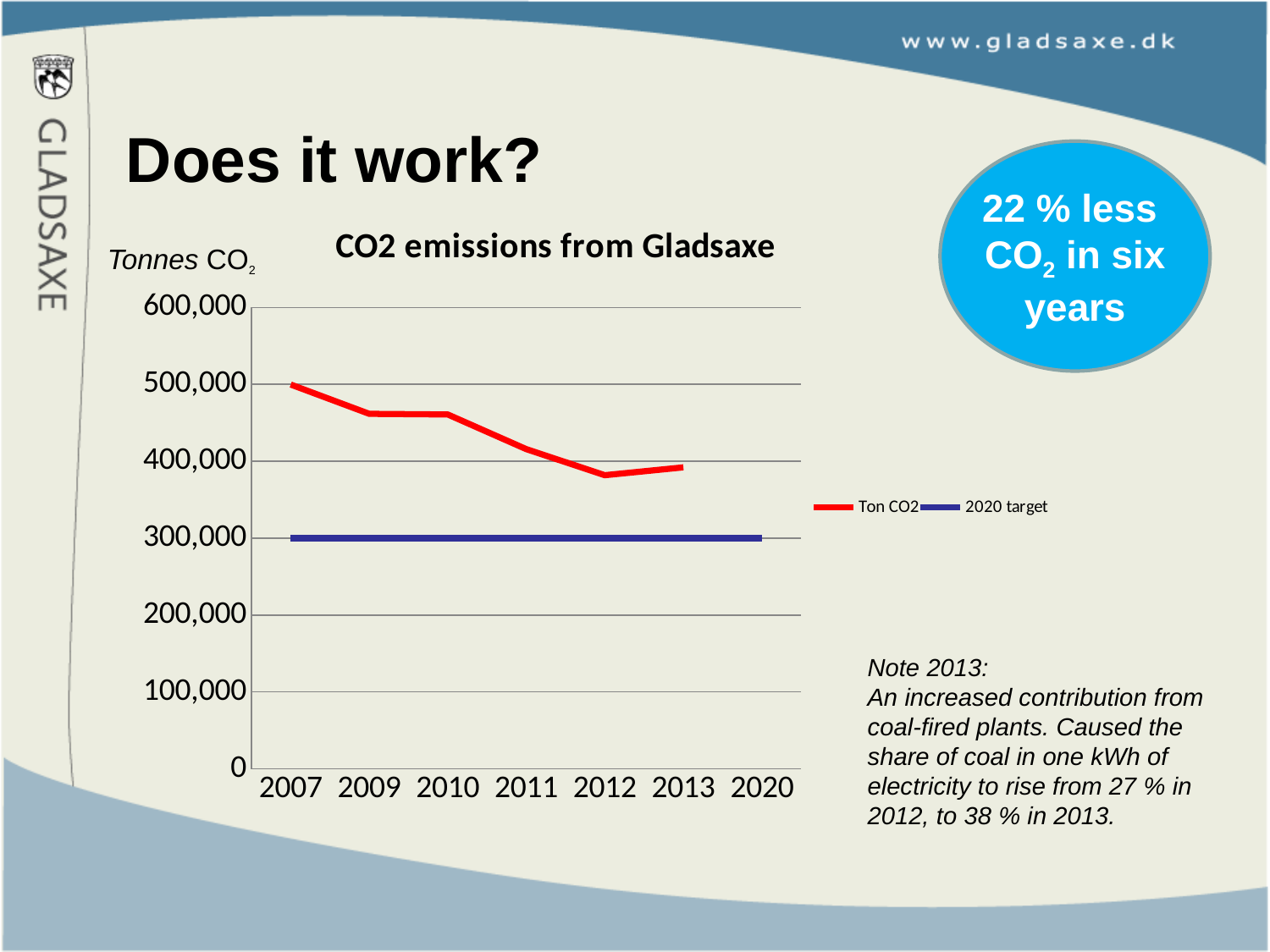
Is the Ton CO2 value for 2012 greater or less than 400,000? less Does the Ton CO2 line rise or fall from 2007 to 2012? fall What kind of chart is shown on the slide? line chart What is the title of the chart? CO2 emissions from Gladsaxe How many years are labelled on the x axis of the chart? 7 How many series does the legend of the chart list? 2 In which year is the Ton CO2 value highest? 2007 Which is larger in 2013: the Ton CO2 value or the 2020 target? Ton CO2 What colour is the Ton CO2 line in the chart? red Is the Ton CO2 value for 2007 greater or less than 400,000? greater In which year is the Ton CO2 value lowest? 2012